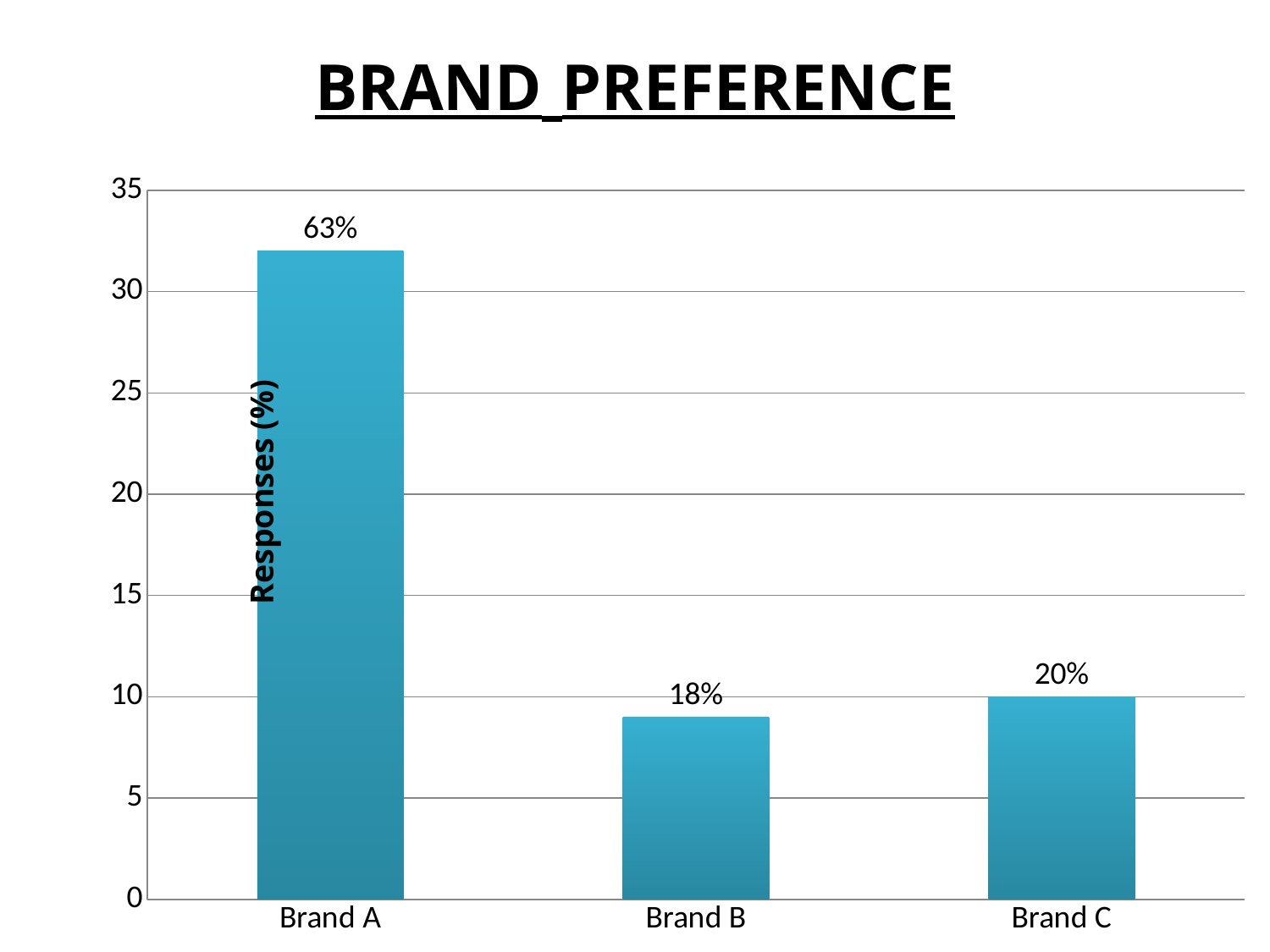
What is the difference between the data labels for Brand A and Brand B? 45% Which is larger, the value for Brand A or the value for Brand C? Brand A Is the bar for Brand A greater or less than 30 on the vertical axis? greater Which brand has the lowest value? Brand B What is the data label shown for Brand C? 20% What is the data label shown for Brand B? 18% Which brand has the highest value? Brand A What type of chart is shown on the slide? Bar chart How many brands are shown on the chart? 3 What is the data label shown for Brand A? 63% What is the difference between the data labels for Brand C and Brand B? 2% Is the bar for Brand B greater or less than 10 on the vertical axis? less